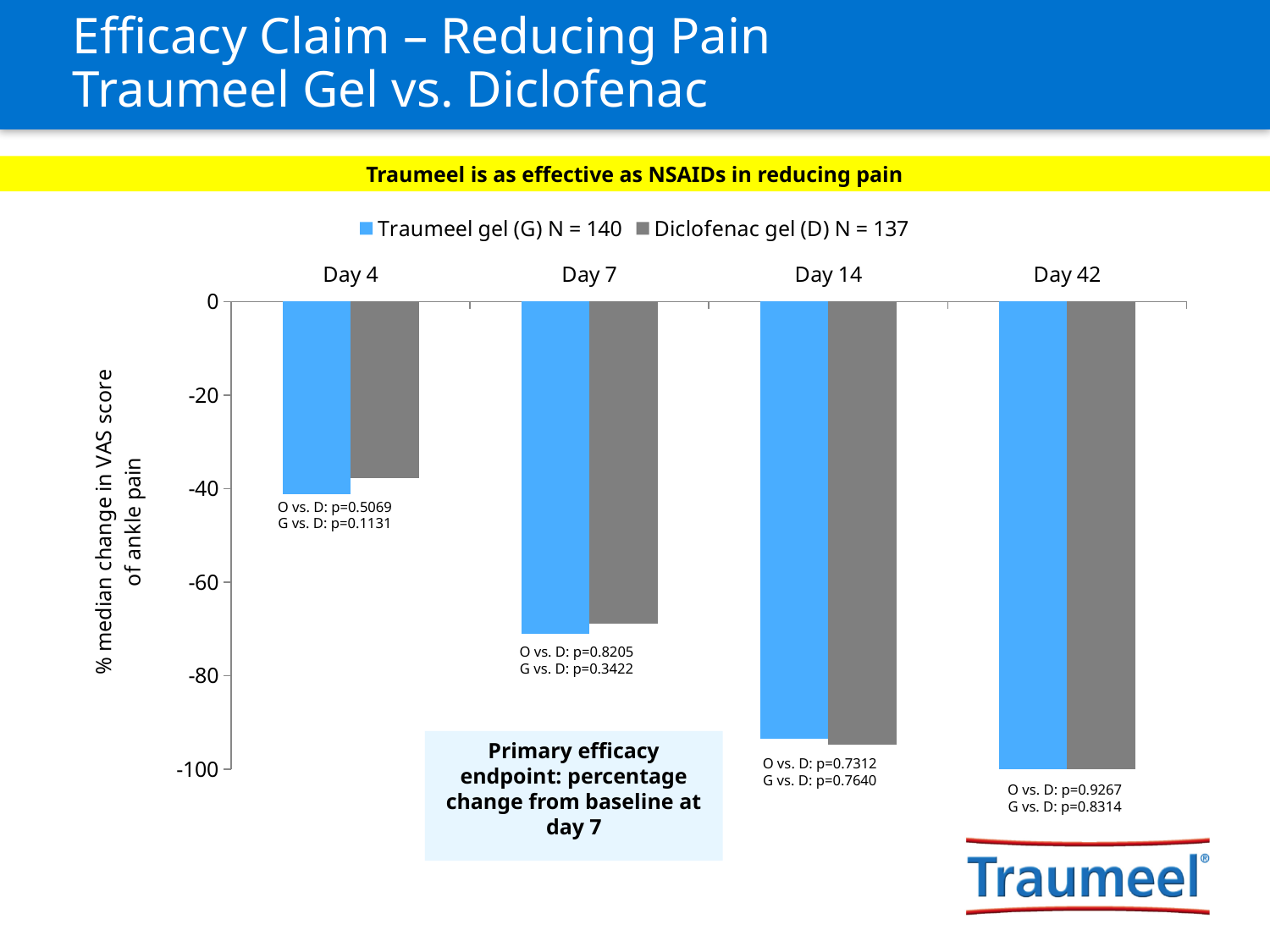
What sample size (N) does the legend give for Diclofenac gel (D)? N = 137 At Day 4, which bar shows the larger decrease, Traumeel gel (G) or Diclofenac gel (D)? Traumeel gel (G) Which time point shows the smallest decrease in VAS score for Diclofenac gel? Day 4 How many series does the legend list? 2 Do the values for Traumeel gel rise or fall from Day 4 to Day 42? fall Is the value for Traumeel gel at Day 7 greater or less than -60? less What is the G vs. D p-value printed for Day 7? p=0.3422 At Day 7, which bar shows the larger decrease, Traumeel gel (G) or Diclofenac gel (D)? Traumeel gel (G) Which time point shows the largest decrease in VAS score for Traumeel gel? Day 42 What kind of chart is shown on the slide? Bar chart Is the value for Diclofenac gel at Day 4 greater or less than -40? greater How many time points (categories) are shown on the x axis? 4